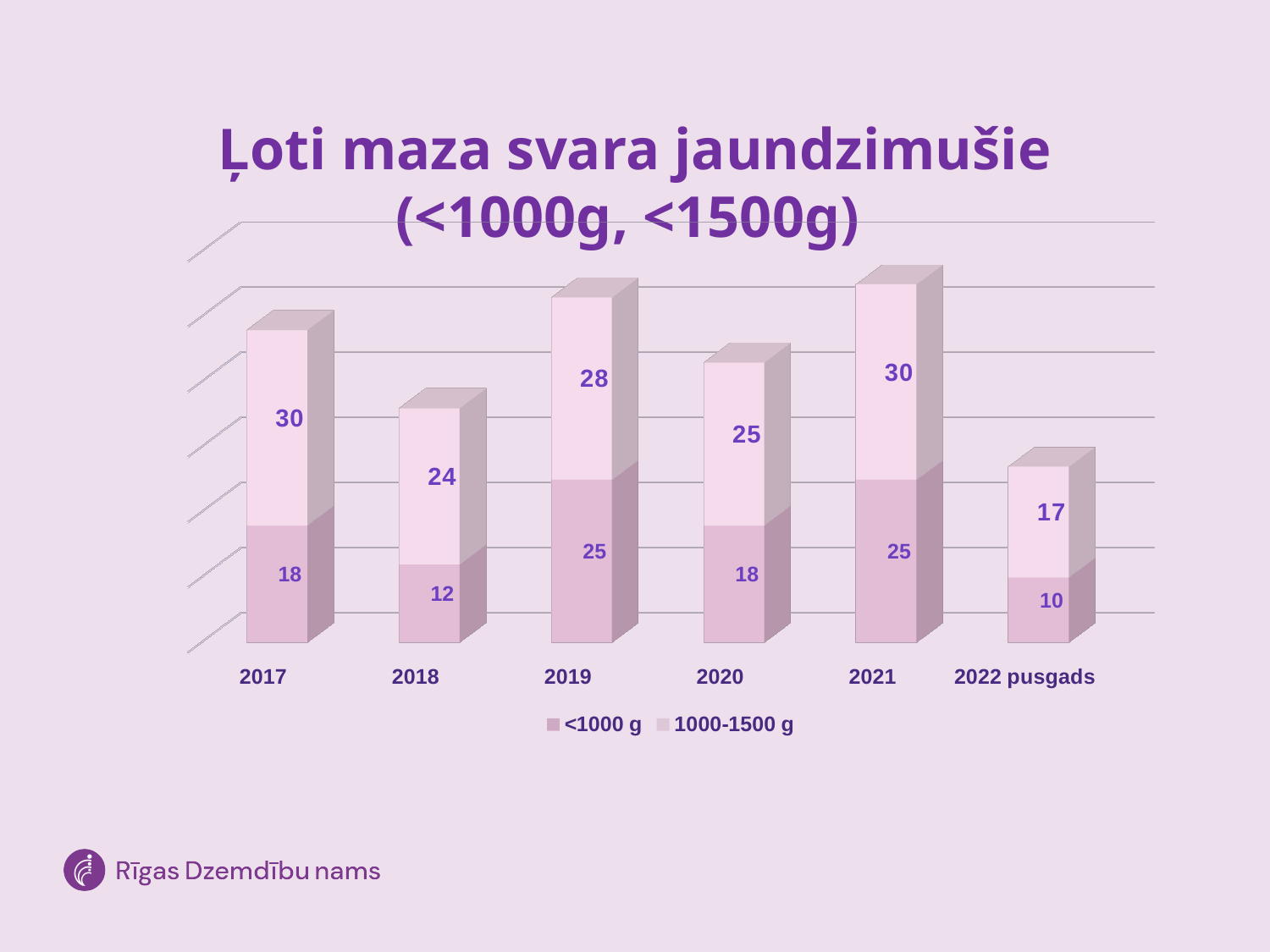
What kind of chart is shown on the slide? Stacked bar chart Which is larger: the <1000 g value for 2018 or for 2020? 2020 What is the value for 1000-1500 g in 2018? 24 How many categories are shown on the x axis? 6 Which category has the highest stacked total? 2021 How many series does the legend list? 2 What is the difference between the 1000-1500 g values for 2017 and 2020? 5 What is the value for <1000 g in 2022 pusgads? 10 What is the title of the chart? Ļoti maza svara jaundzimušie (<1000g, <1500g) Which year has the lowest value for <1000 g? 2022 pusgads What is the value for <1000 g in 2019? 25 What is the total of the stacked bar for 2019? 53